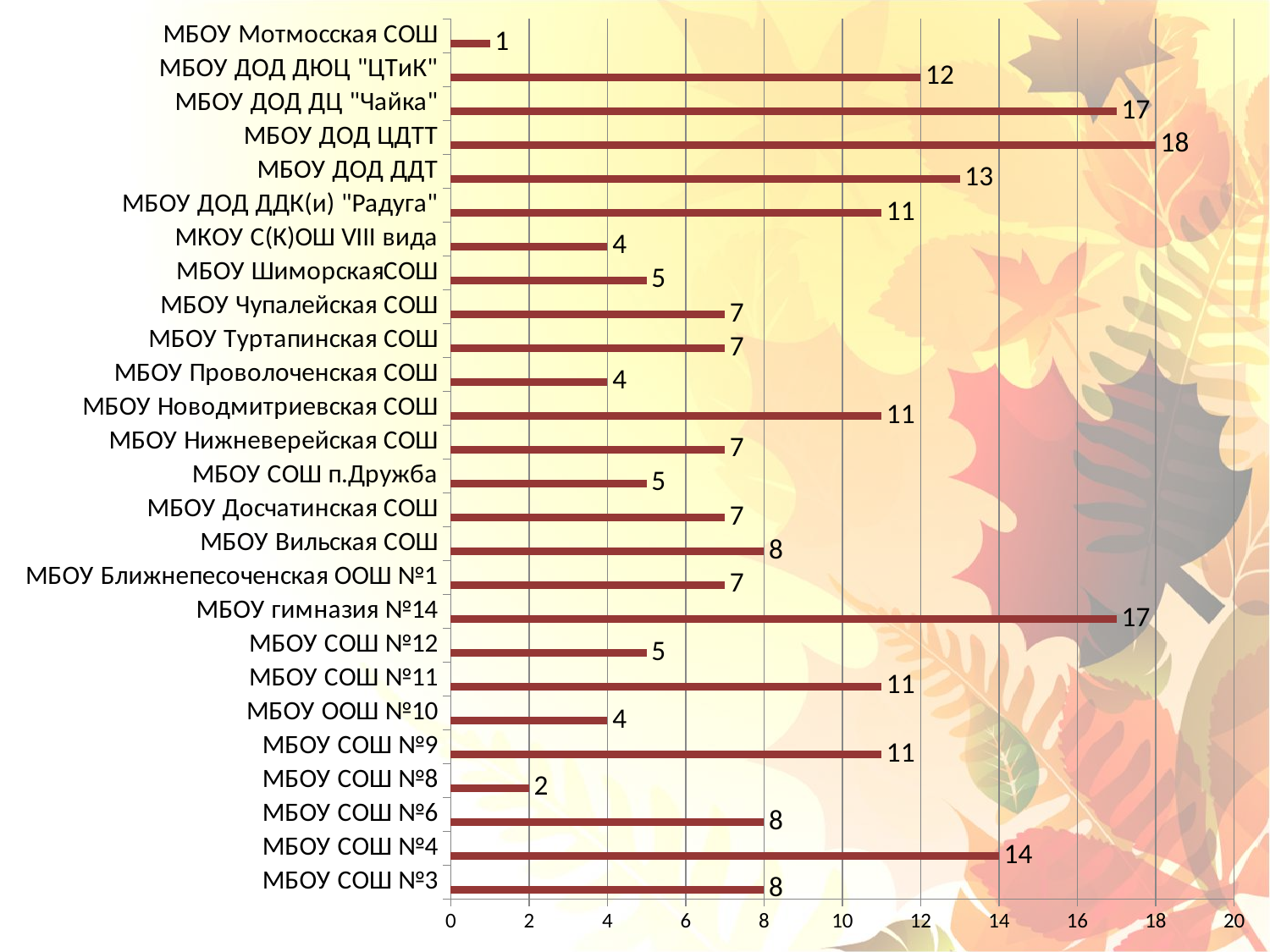
What is the difference between the values for МБОУ СОШ №4 and МБОУ СОШ №3? 6 What is the difference between the values for МБОУ ДОД ЦДТТ and МБОУ ДОД ДДТ? 5 Which category has the lowest value? МБОУ Мотмосская СОШ Is the value for МБОУ ДОД ДЦ "Чайка" greater or less than 10? greater What is the value for МБОУ ДОД ЦДТТ? 18 What is the value for МБОУ гимназия №14? 17 Which is larger, the value for МБОУ ДОД ДЮЦ "ЦТиК" or the value for МБОУ СОШ №11? МБОУ ДОД ДЮЦ "ЦТиК" What kind of chart is shown on the slide? bar chart What is the value for МБОУ СОШ №8? 2 What is the value for МБОУ СОШ №4? 14 How many categories are shown on the chart? 26 Which category has the highest value? МБОУ ДОД ЦДТТ